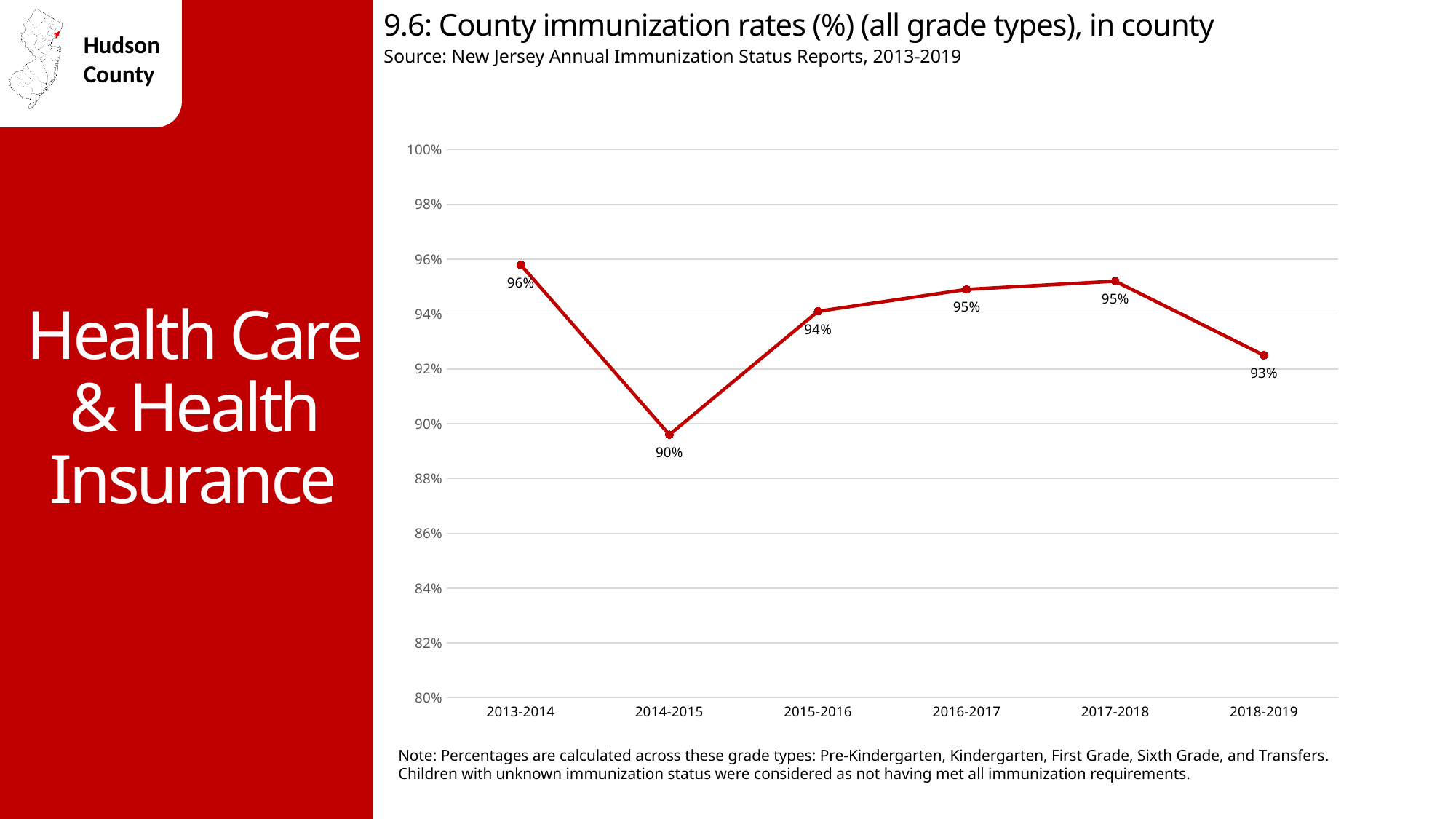
How many school years are plotted on the chart? 6 By how many percentage points did the immunization rate drop from 2013-2014 to 2014-2015? 6 percentage points Is the immunization rate for 2014-2015 greater or less than 92%? less What was the county immunization rate in 2018-2019? 93% Which year had a higher immunization rate, 2015-2016 or 2018-2019? 2015-2016 Which school year had the highest immunization rate? 2013-2014 What was the county immunization rate in 2014-2015? 90% Did the immunization rate rise or fall from 2017-2018 to 2018-2019? fall What kind of chart is used to show the county immunization rates? line chart Which school year had the lowest immunization rate? 2014-2015 What is the source cited for the immunization rate chart? New Jersey Annual Immunization Status Reports, 2013-2019 What was the county immunization rate in 2013-2014? 96%